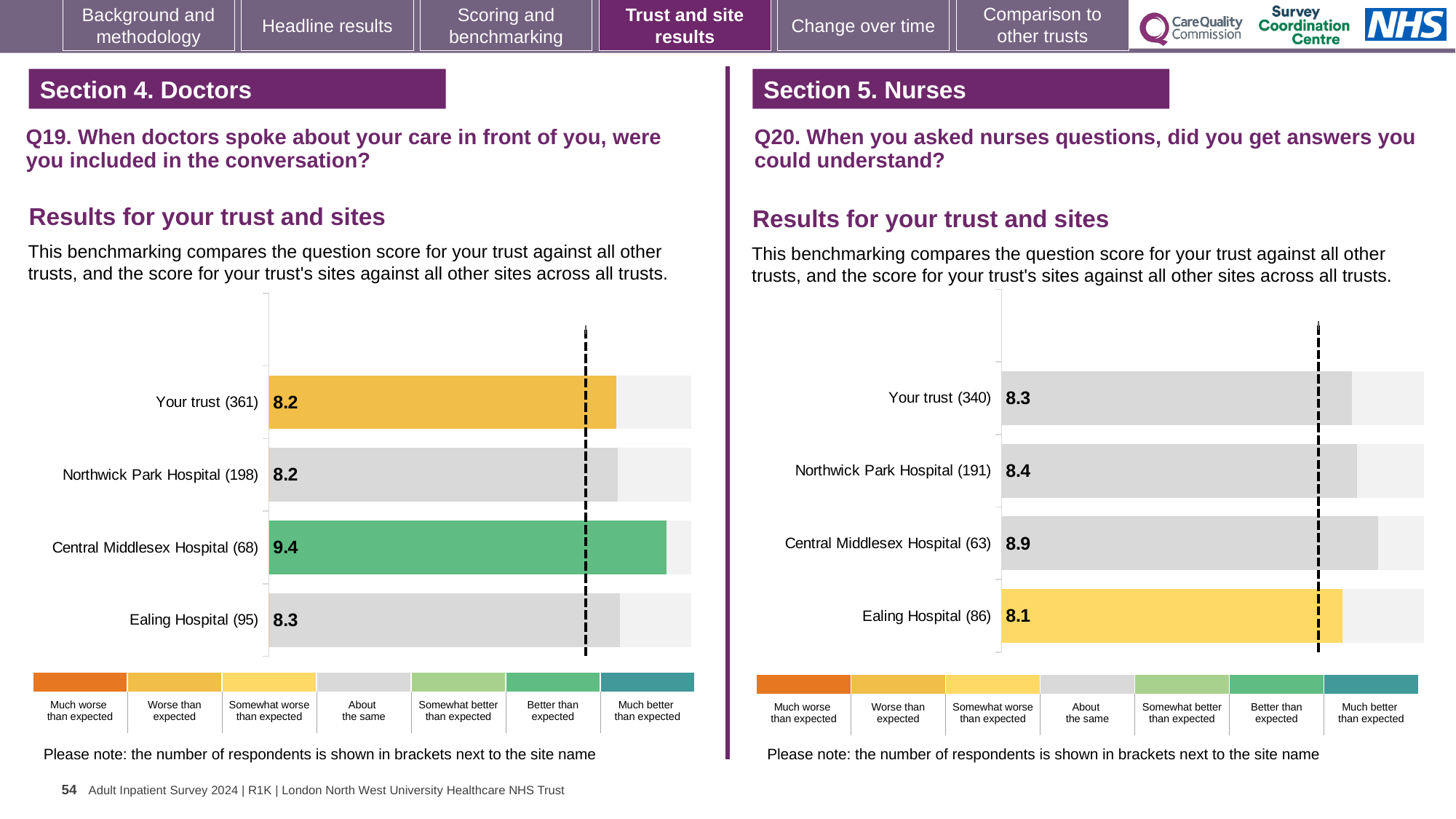
On the Q19 chart (left), what is the score for Central Middlesex Hospital? 9.4 On the Q20 chart (right), what is the score for Northwick Park Hospital? 8.4 On the Q20 chart (right), which site has the lowest score? Ealing Hospital On the Q19 chart (left), which site has the highest score? Central Middlesex Hospital On the Q19 chart (left), what is the difference between the scores for Central Middlesex Hospital and Ealing Hospital? 1.1 On the Q20 chart (right), what is the difference between the scores for Central Middlesex Hospital and Your trust? 0.6 What kind of chart is used on the Q19 chart (left)? Bar chart On the Q20 chart (right), which is larger: the score for Central Middlesex Hospital or the score for Your trust? Central Middlesex Hospital On the Q19 chart (left), how many bars are plotted? 4 On the Q20 chart (right), how many respondents are shown in brackets for Your trust? 340 On the Q19 chart (left), what is the score for Your trust? 8.2 On the Q20 chart (right), what is the score for Ealing Hospital? 8.1